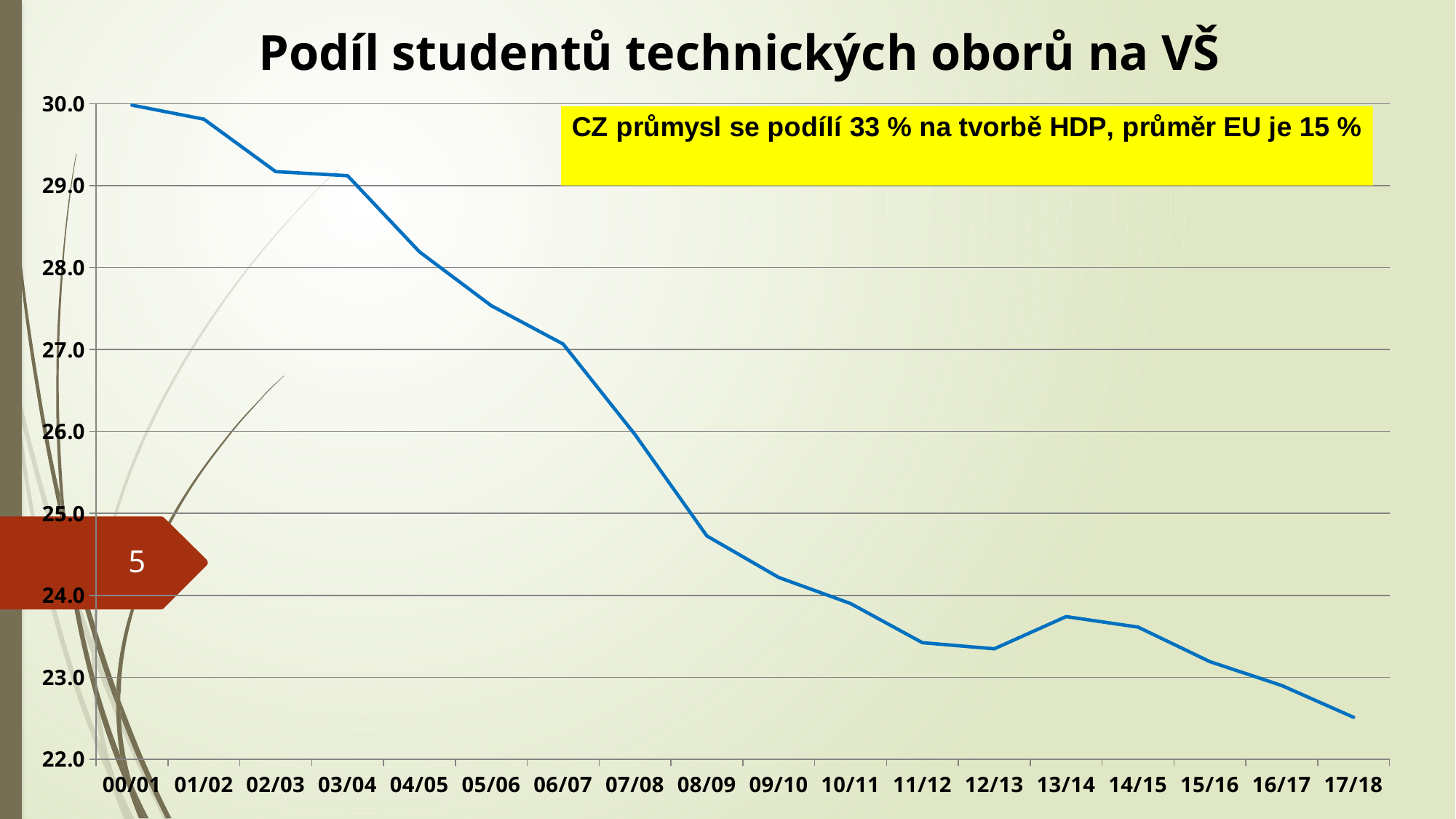
Which academic year has the highest value? 00/01 Which academic year has the lowest value? 17/18 Do the values generally rise or fall from 00/01 to 17/18? fall Which is larger, the value for 13/14 or the value for 12/13? 13/14 What does the yellow text box on the chart say? CZ průmysl se podílí 33 % na tvorbě HDP, průměr EU je 15 % How many academic years are plotted along the x axis? 18 Is the value for 17/18 greater or less than 23.0? less Is the value for 04/05 greater or less than 28.0? greater What is the title of the chart? Podíl studentů technických oborů na VŠ What kind of chart is shown on the slide? line chart Is the value for 08/09 greater or less than 25.0? less